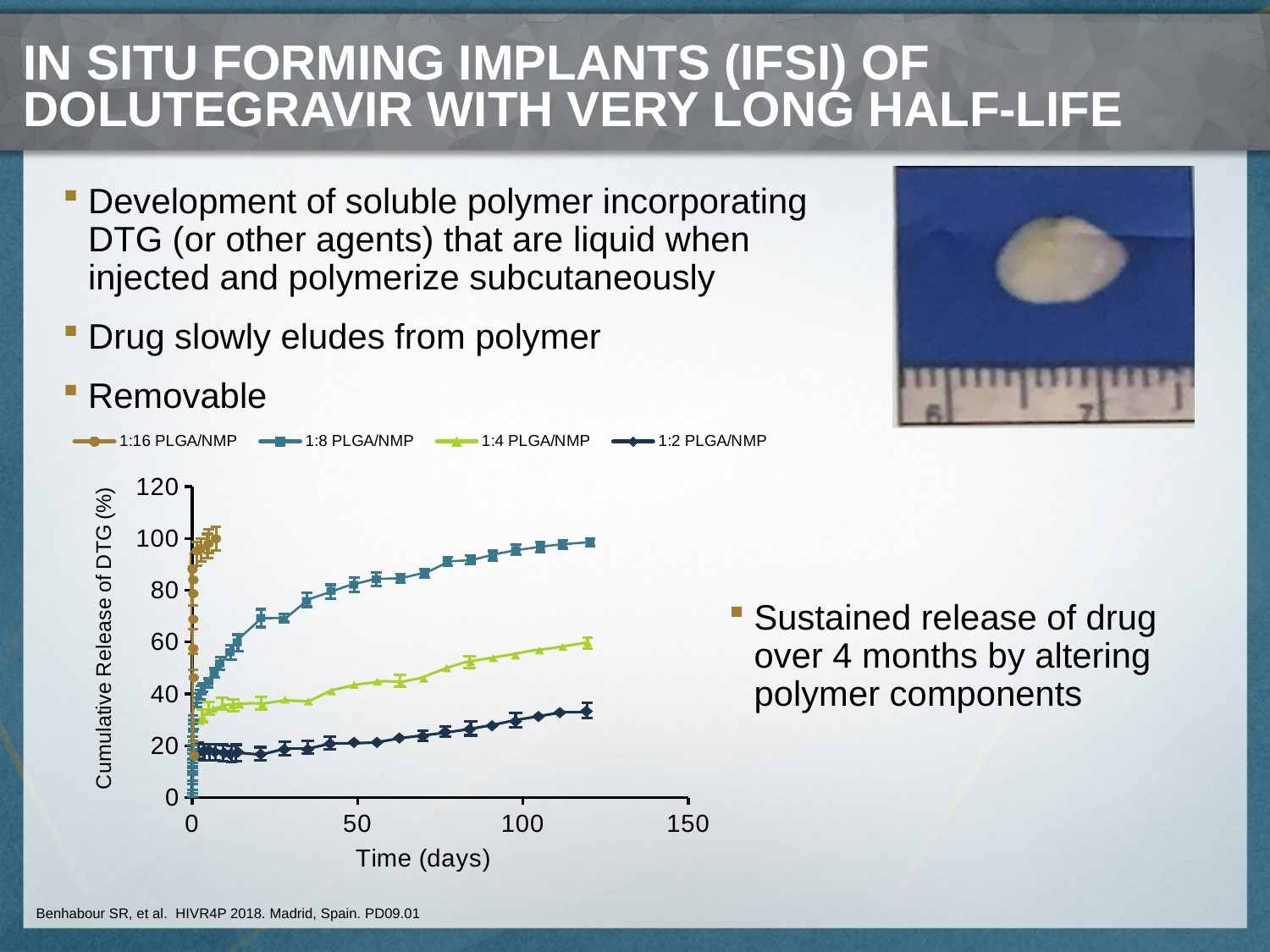
What kind of chart is shown on the slide? line chart At 50 days, which series has the higher cumulative release: 1:2 PLGA/NMP or 1:4 PLGA/NMP? 1:4 PLGA/NMP At 100 days, which series has the higher cumulative release: 1:8 PLGA/NMP or 1:4 PLGA/NMP? 1:8 PLGA/NMP What is the title of the chart's x axis? Time (days) Is the cumulative release for 1:8 PLGA/NMP at 120 days greater or less than 80? greater Is the cumulative release for 1:2 PLGA/NMP at 120 days greater or less than 40? less Does the cumulative release for 1:4 PLGA/NMP rise or fall as time increases? rise What is the title of the chart's y axis? Cumulative Release of DTG (%) How many series does the chart legend list? 4 Which series has the lowest cumulative release of DTG at 120 days? 1:2 PLGA/NMP Which series reaches about 100% cumulative release of DTG within the first 10 days? 1:16 PLGA/NMP Is the cumulative release for 1:4 PLGA/NMP at 120 days greater or less than 40? greater